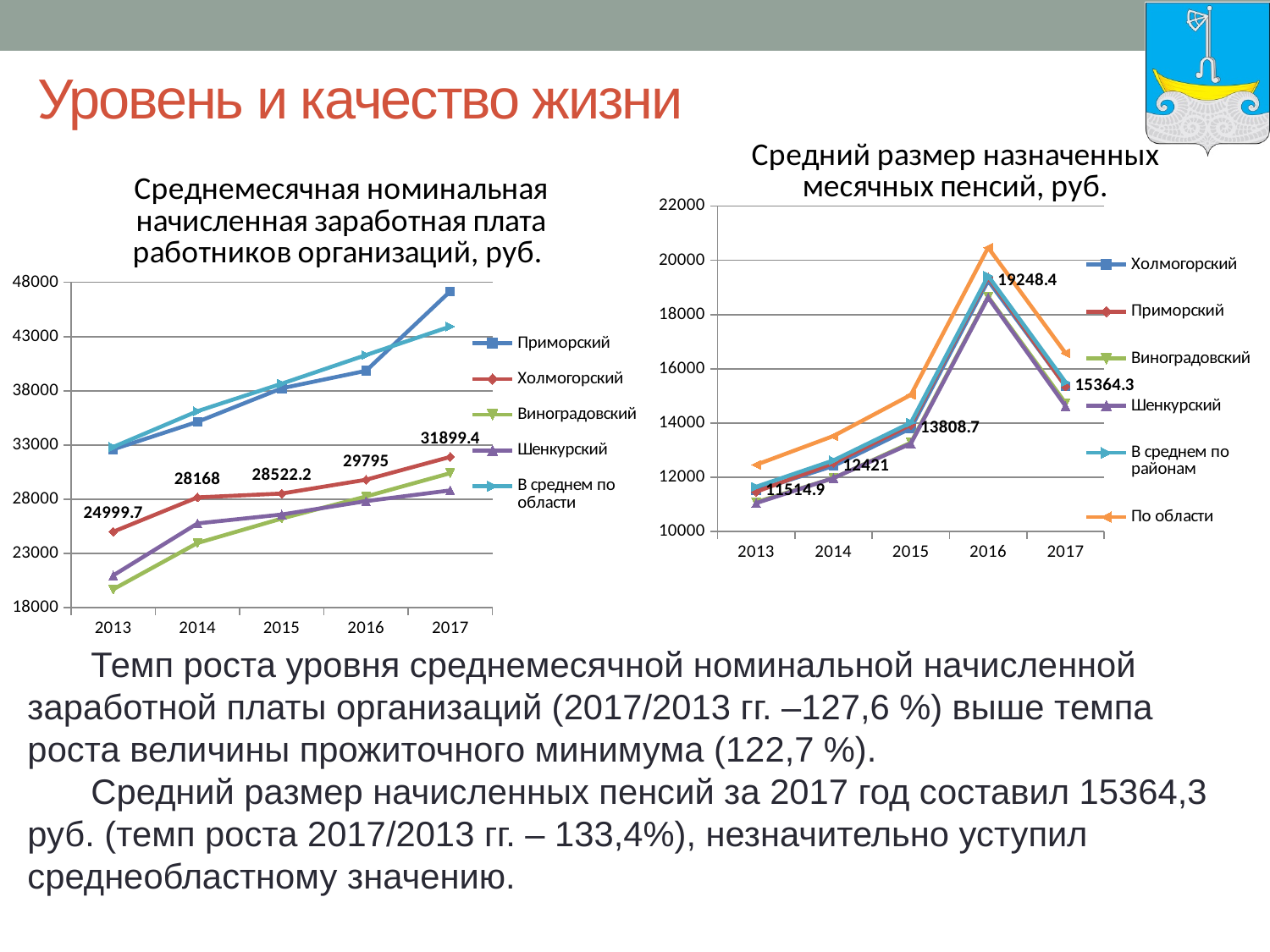
In the chart "Среднемесячная номинальная начисленная заработная плата работников организаций, руб.", which series has the lowest value in 2013? Виноградовский In the chart "Среднемесячная номинальная начисленная заработная плата работников организаций, руб.", which series has the highest value in 2017? Приморский In the chart "Среднемесячная номинальная начисленная заработная плата работников организаций, руб.", what is the value for Холмогорский in 2017? 31899.4 In the chart "Средний размер назначенных месячных пенсий, руб.", what is the difference between the Холмогорский values in 2016 and 2017? 3884.1 In the chart "Среднемесячная номинальная начисленная заработная плата работников организаций, руб.", is the value for Приморский in 2017 greater or less than 43000? greater In the chart "Среднемесячная номинальная начисленная заработная плата работников организаций, руб.", by how much did the Холмогорский value increase from 2016 to 2017? 2104.4 In the chart "Среднемесячная номинальная начисленная заработная плата работников организаций, руб.", what is the value for Холмогорский in 2013? 24999.7 In the chart "Средний размер назначенных месячных пенсий, руб.", what is the value for Холмогорский in 2016? 19248.4 In the chart "Средний размер назначенных месячных пенсий, руб.", how many series does the legend list? 6 What type of chart is "Средний размер назначенных месячных пенсий, руб."? line chart In the chart "Среднемесячная номинальная начисленная заработная плата работников организаций, руб.", how many series does the legend list? 5 In the chart "Средний размер назначенных месячных пенсий, руб.", in which year does Холмогорский reach its highest value? 2016